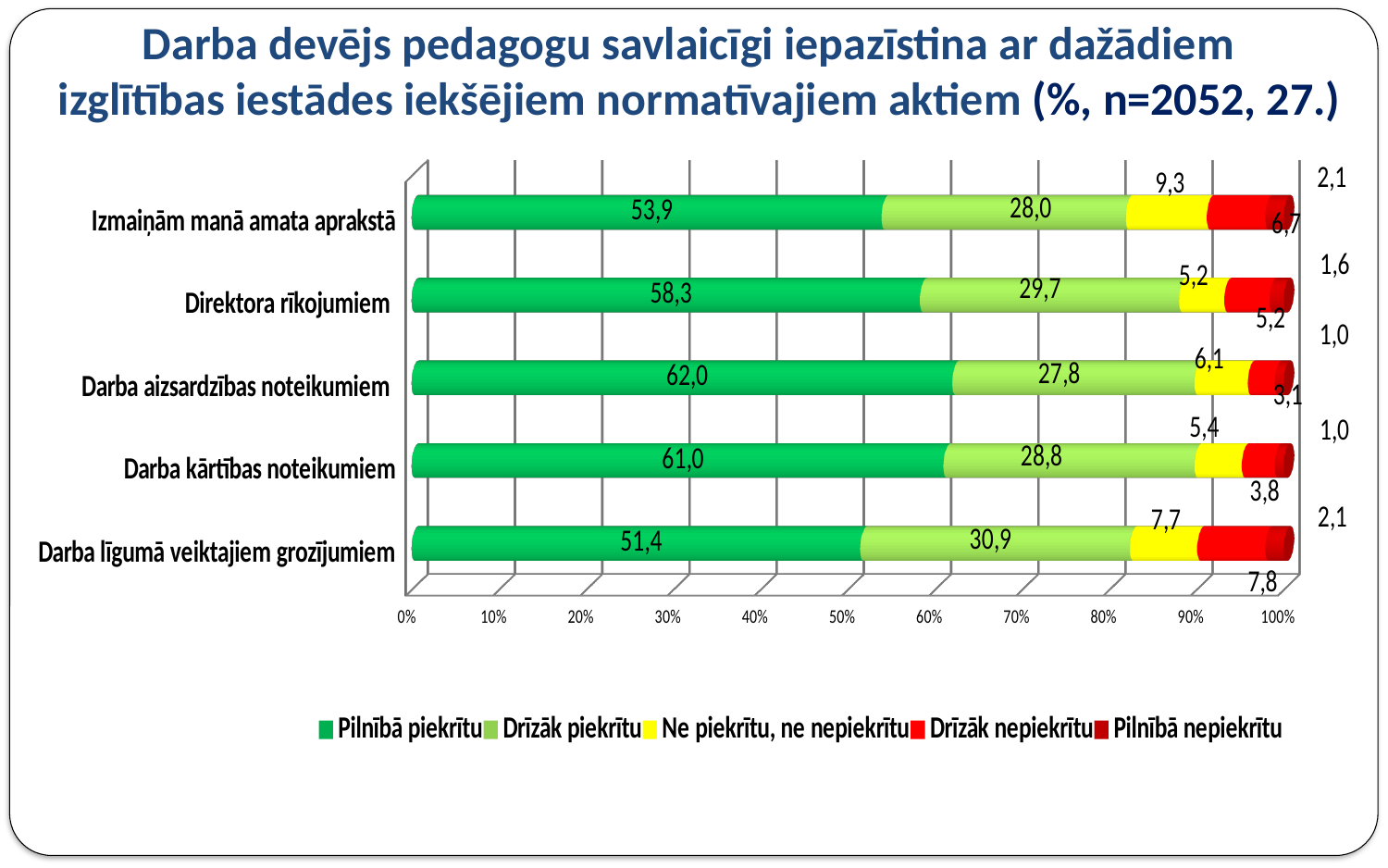
What is the value of "Drīzāk piekrītu" for "Darba līgumā veiktajiem grozījumiem"? 30,9 What is the value of "Drīzāk nepiekrītu" for "Direktora rīkojumiem"? 5,2 How many categories are shown on the chart? 5 How many series does the legend list? 5 What is the value of "Ne piekrītu, ne nepiekrītu" for "Izmaiņām manā amata aprakstā"? 9,3 Which is larger: the "Drīzāk piekrītu" value for "Darba kārtības noteikumiem" or for "Darba aizsardzības noteikumiem"? Darba kārtības noteikumiem Which colour represents "Ne piekrītu, ne nepiekrītu" in the legend? Yellow What is the difference between the "Pilnībā piekrītu" values for "Direktora rīkojumiem" and "Izmaiņām manā amata aprakstā"? 4,4 What is the value of "Pilnībā piekrītu" for "Darba aizsardzības noteikumiem"? 62,0 What kind of chart is shown on the slide? Stacked bar chart Which category has the highest "Pilnībā piekrītu" value? Darba aizsardzības noteikumiem Which category has the lowest "Pilnībā piekrītu" value? Darba līgumā veiktajiem grozījumiem